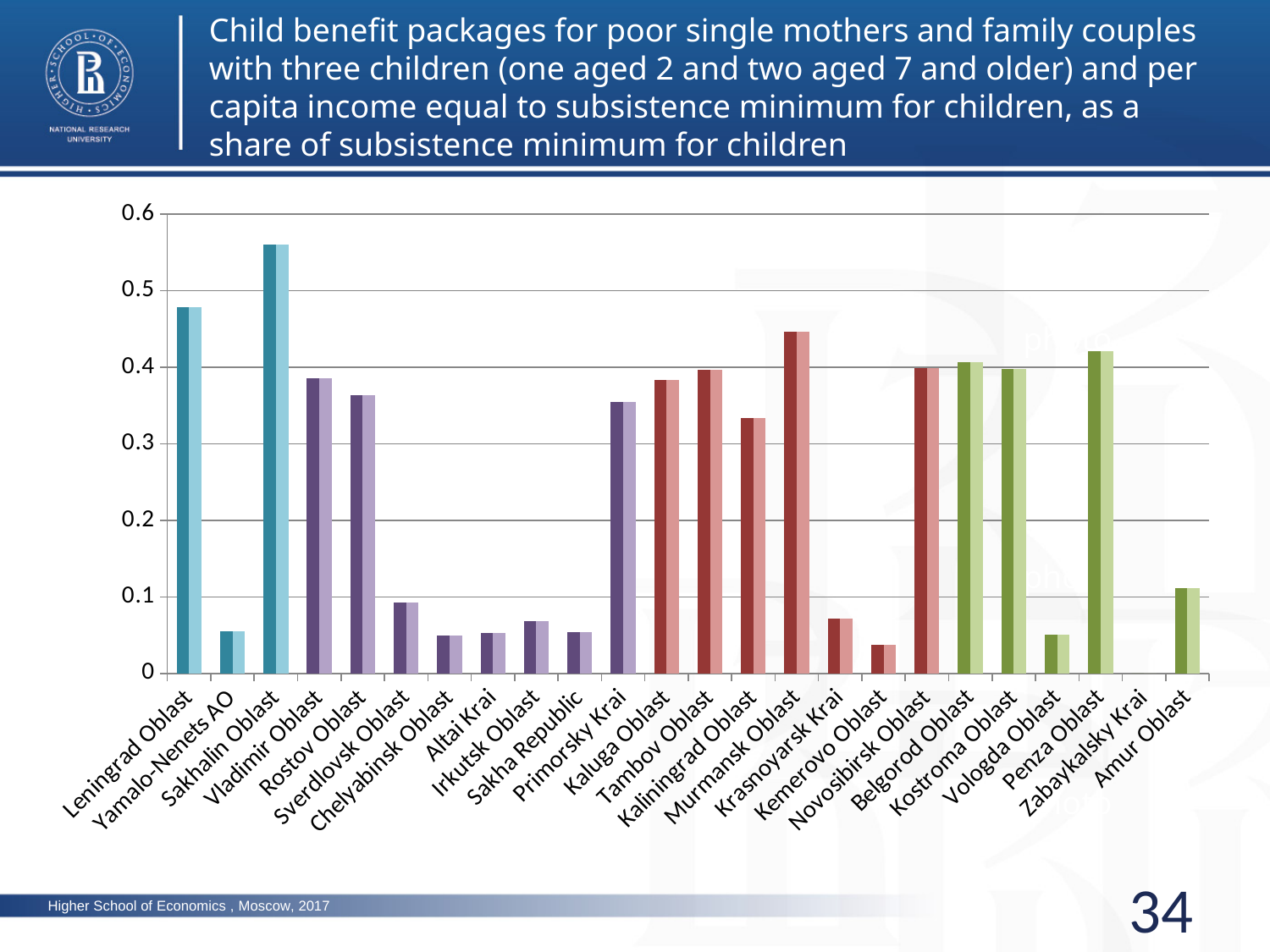
What kind of chart is shown on the slide? bar chart Is the value for Vologda Oblast greater or less than 0.1? less Is the value for Yamalo-Nenets AO greater or less than 0.1? less Which has the larger value, Murmansk Oblast or Kaliningrad Oblast? Murmansk Oblast Is the value for Kaliningrad Oblast greater or less than 0.3? greater What is the highest value shown on the y axis of the chart? 0.6 Which has the larger value, Sakhalin Oblast or Leningrad Oblast? Sakhalin Oblast Which region has the highest value in the chart? Sakhalin Oblast How many regions are listed along the x axis of the chart? 24 Which has the larger value, Krasnoyarsk Krai or Kemerovo Oblast? Krasnoyarsk Krai